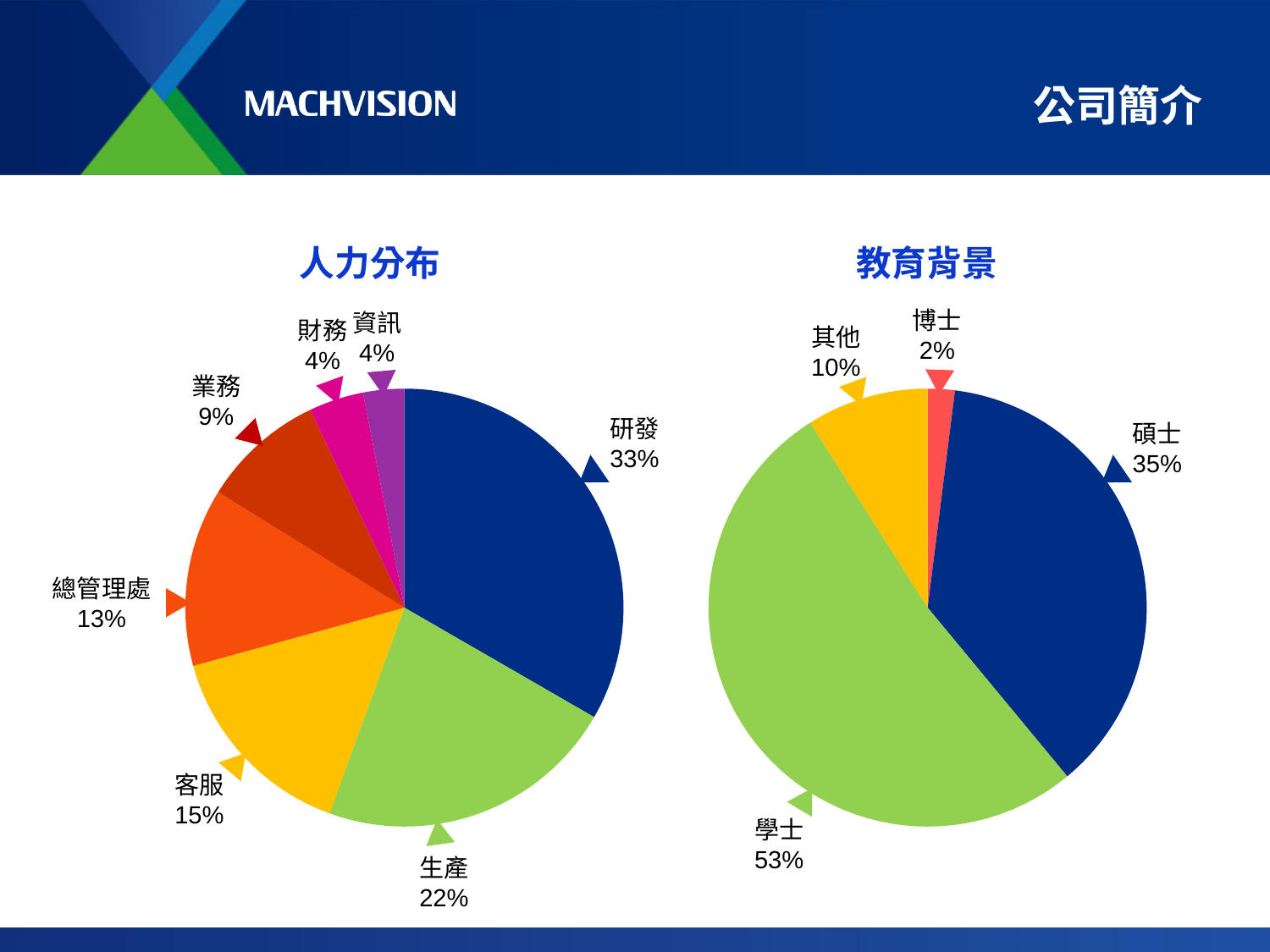
In the 人力分布 chart, what share does 研發 have? 33% In the 人力分布 chart, which category has the largest share? 研發 In the 教育背景 chart, how many categories are shown? 4 In the 人力分布 chart, what share does 客服 have? 15% In the 教育背景 chart, what is the difference between the shares of 學士 and 碩士? 18% What kind of chart is the 教育背景 chart? pie chart In the 人力分布 chart, which is larger, 業務 or 客服? 客服 In the 教育背景 chart, what share does 學士 have? 53% What is the title of the chart on the left? 人力分布 In the 人力分布 chart, how many categories are shown? 7 In the 教育背景 chart, which category has the smallest share? 博士 In the 人力分布 chart, what is the difference between the shares of 生產 and 總管理處? 9%